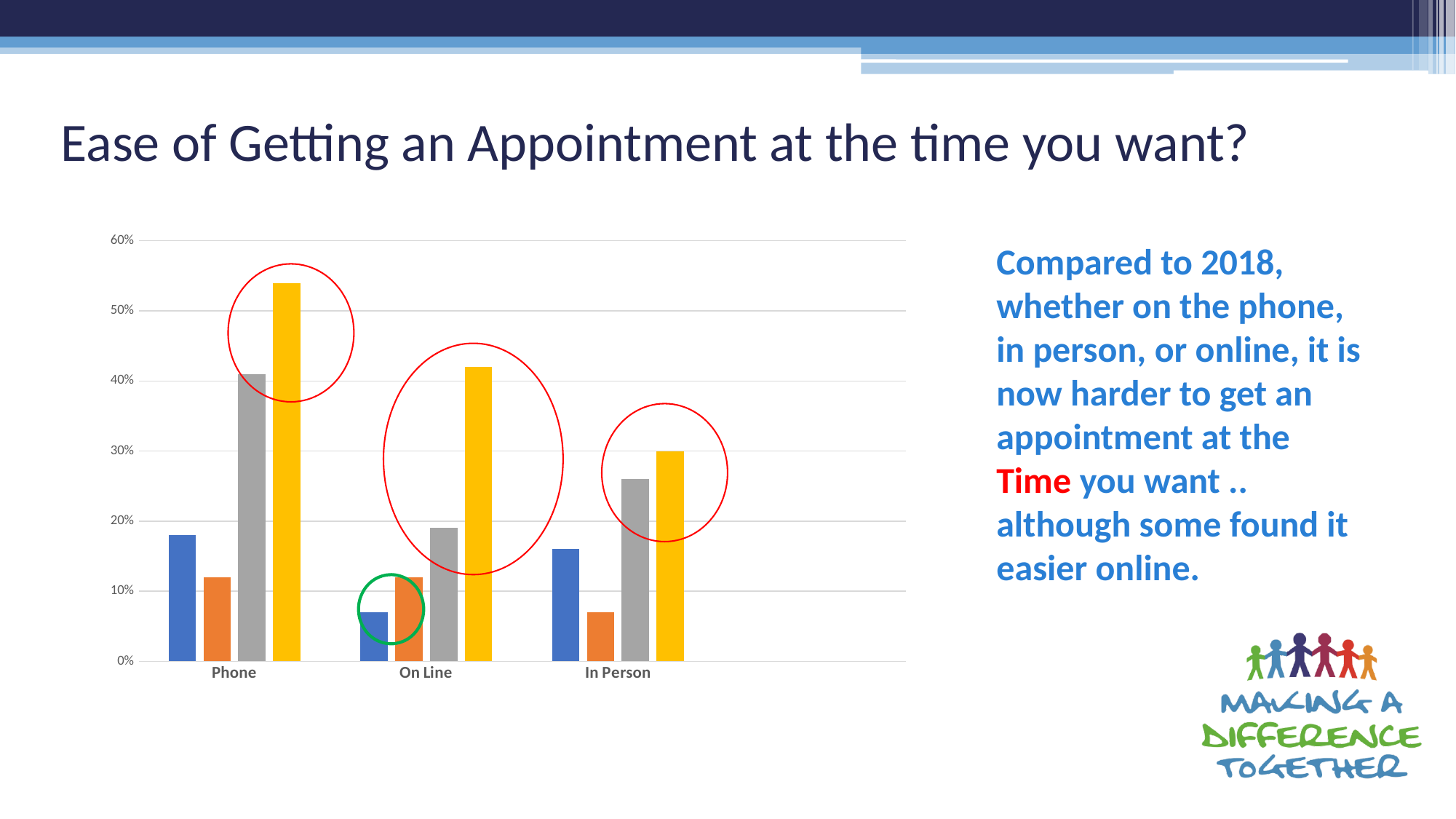
Is the value of the yellow bar for Phone greater or less than 50%? greater Is the value of the blue bar for On Line greater or less than 10%? less What is the title of the slide containing the chart? Ease of Getting an Appointment at the time you want? Which is larger, the yellow bar for Phone or the yellow bar for In Person? Phone What kind of chart is shown on the slide? bar chart Is the value of the gray bar for In Person greater or less than 30%? less How many bars are plotted for each category in the chart? 4 How many categories are shown on the x axis of the chart? 3 What are the three categories on the x axis of the chart? Phone, On Line, In Person Which category contains the tallest bar in the chart? Phone